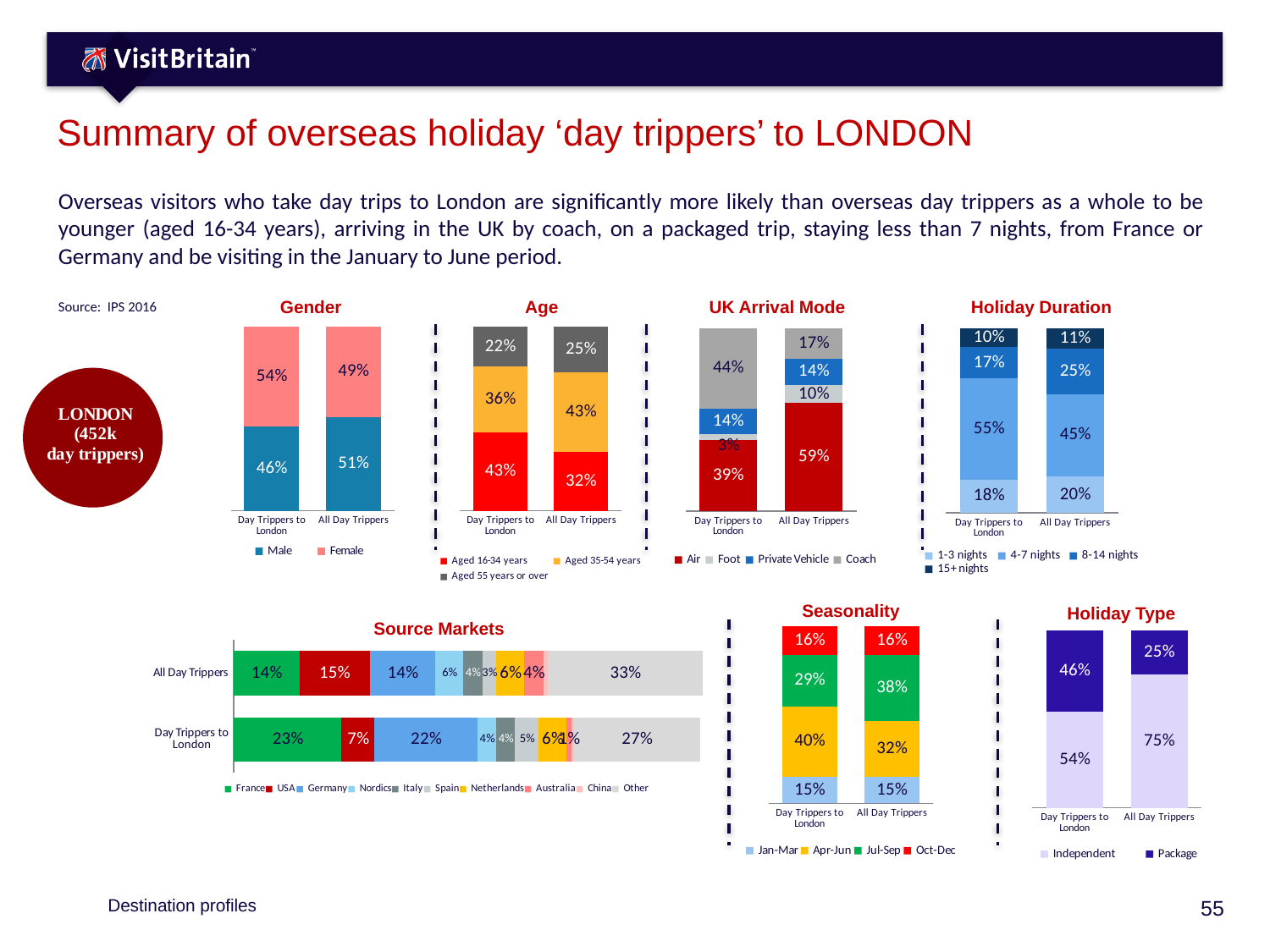
How many series does the legend of the Source Markets chart list? 10 In the UK Arrival Mode chart, what is the difference between the Air share for All Day Trippers and for Day Trippers to London? 20% In the UK Arrival Mode chart, what is the Coach share for Day Trippers to London? 44% In the Holiday Duration chart, which duration category has the largest share for Day Trippers to London? 4-7 nights In the Gender chart, what percentage of Day Trippers to London are Male? 46% In the Source Markets chart, which is larger for Day Trippers to London: the USA share or the Germany share? Germany In the Seasonality chart, what is the Apr-Jun share for Day Trippers to London? 40% In the Holiday Duration chart, what is the 8-14 nights share for All Day Trippers? 25% In the Source Markets chart, what is the France share for Day Trippers to London? 23% In the Age chart, what percentage of All Day Trippers are Aged 35-54 years? 43% In the Seasonality chart, which quarter has the largest share for All Day Trippers? Jul-Sep In the Holiday Type chart, what is the Package share for All Day Trippers? 25%